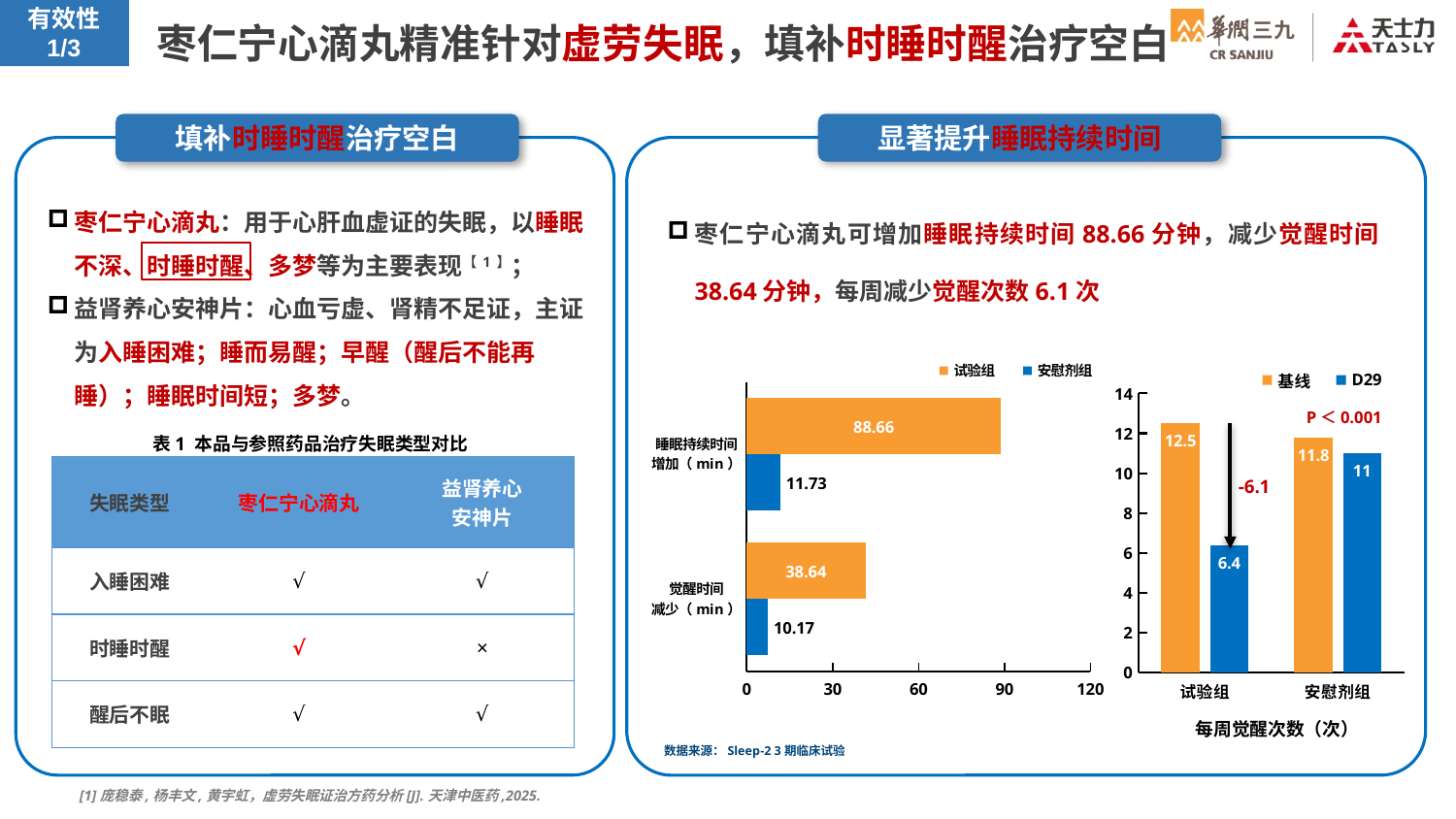
In the horizontal bar chart on the right side of the slide, what is the highest value shown on the x axis? 120 In the chart titled 每周觉醒次数（次）, what kind of chart is shown? Bar chart In the chart titled 每周觉醒次数（次）, what is the 基线 value for 试验组? 12.5 In the horizontal bar chart on the right side of the slide, what is the value for 安慰剂组 in the 觉醒时间减少（min） category? 10.17 In the horizontal bar chart on the right side of the slide, which group has the larger value for 觉醒时间减少（min）, 试验组 or 安慰剂组? 试验组 In the chart titled 每周觉醒次数（次）, what is the D29 value for 安慰剂组? 11 In the chart titled 每周觉醒次数（次）, which bar has the lowest value? 试验组 D29 (6.4) In the chart titled 每周觉醒次数（次）, what P value is printed on the chart? P＜0.001 In the chart titled 每周觉醒次数（次）, what is the difference between the 基线 and D29 values for 试验组? 6.1 In the horizontal bar chart on the right side of the slide, what is the value for 试验组 in the 睡眠持续时间增加（min） category? 88.66 In the horizontal bar chart on the right side of the slide, how many series does the legend list? 2 In the horizontal bar chart on the right side of the slide, what is the difference between 试验组 and 安慰剂组 for 睡眠持续时间增加（min）? 76.93